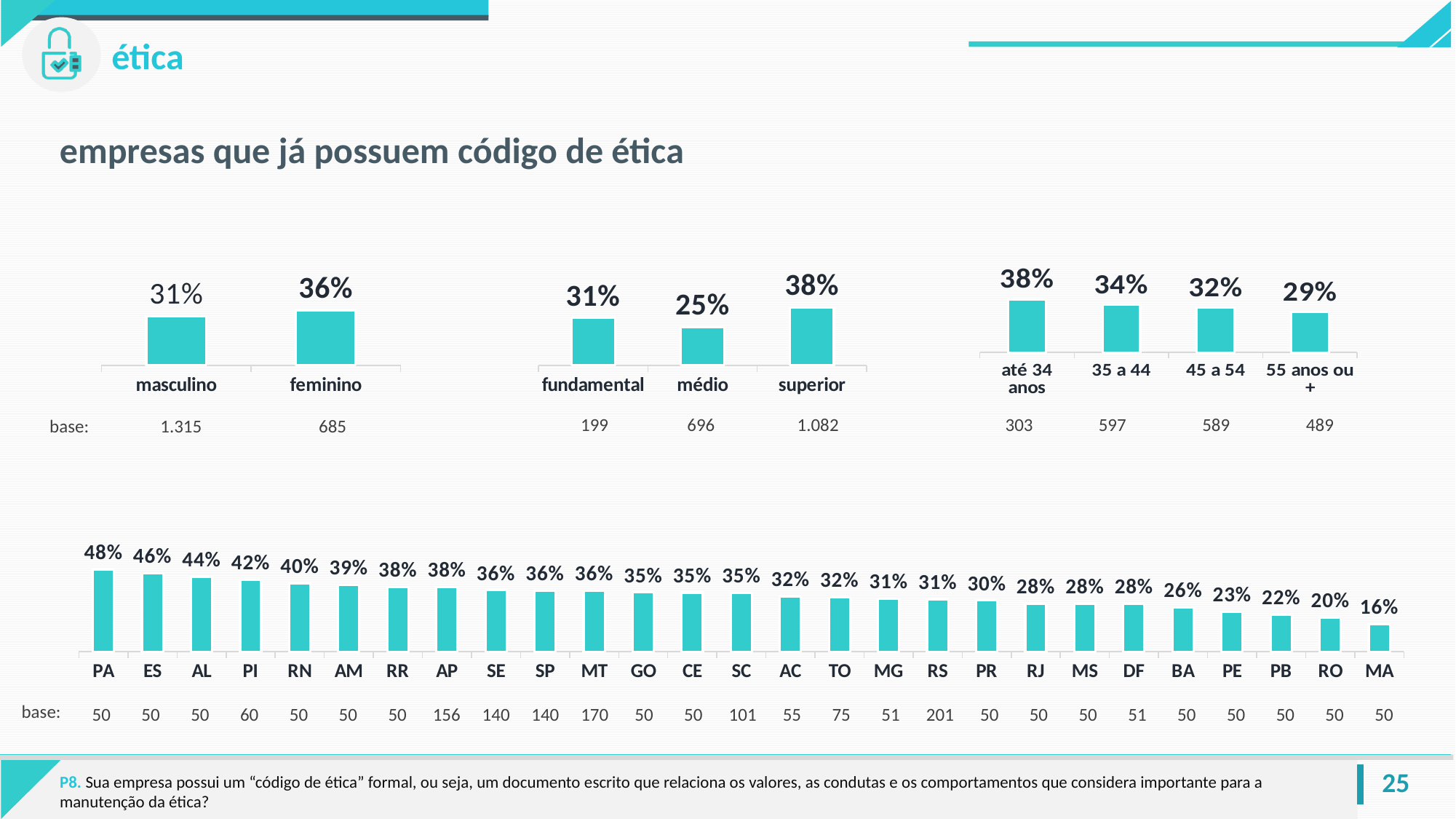
In the state chart (bottom), what is the value for SP? 36% In the state chart (bottom), which state has the highest value? PA In the state chart (bottom), how many states are shown? 27 In the age chart (top right), do the values rise or fall from left to right? fall In the age chart (top right), what is the value for 45 a 54? 32% In the education chart (top centre), what is the value for superior? 38% In the age chart (top right), which age group has the highest value? até 34 anos In the state chart (bottom), which state has the lowest value? MA What kind of chart is the state chart at the bottom of the slide? bar chart In the gender chart (top left), what is the value for feminino? 36% In the education chart (top centre), which category has the lowest value? médio In the gender chart (top left), what is the difference between feminino and masculino? 5%